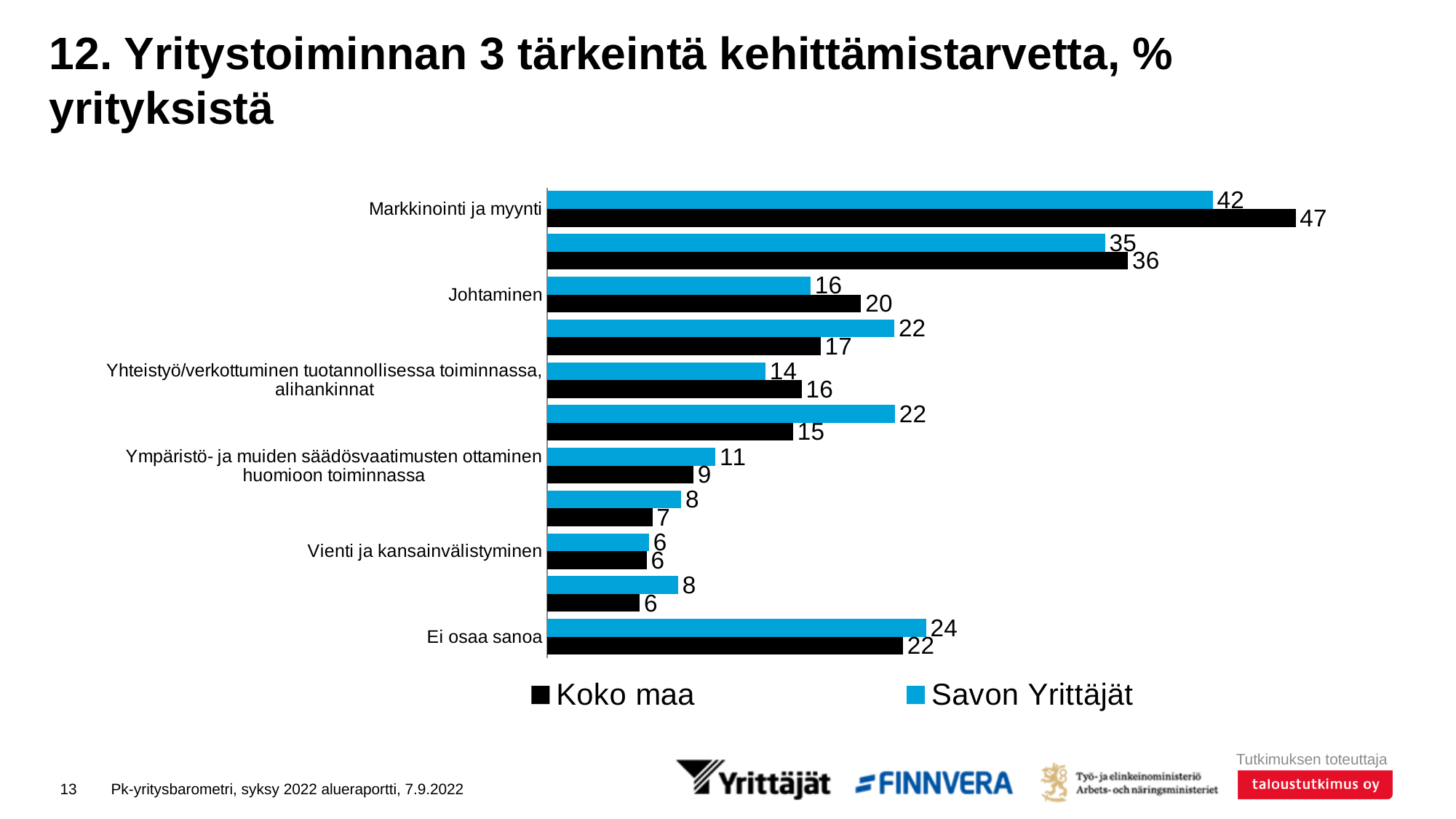
Which colour represents Savon Yrittäjät in the chart? Blue What is the value for Koko maa for Johtaminen? 20 Which labelled category has the lowest value for Savon Yrittäjät? Vienti ja kansainvälistyminen What kind of chart is shown on the slide? Bar chart How many series does the legend list? 2 What is the value for Savon Yrittäjät for Ei osaa sanoa? 24 For Ympäristö- ja muiden säädösvaatimusten ottaminen huomioon toiminnassa, which series has the larger value, Koko maa or Savon Yrittäjät? Savon Yrittäjät Which labelled category has the highest value for Koko maa? Markkinointi ja myynti What is the difference between the Koko maa and Savon Yrittäjät values for Markkinointi ja myynti? 5 What is the value for Koko maa for Vienti ja kansainvälistyminen? 6 What is the value for Savon Yrittäjät for Markkinointi ja myynti? 42 What is the value for Koko maa for Markkinointi ja myynti? 47